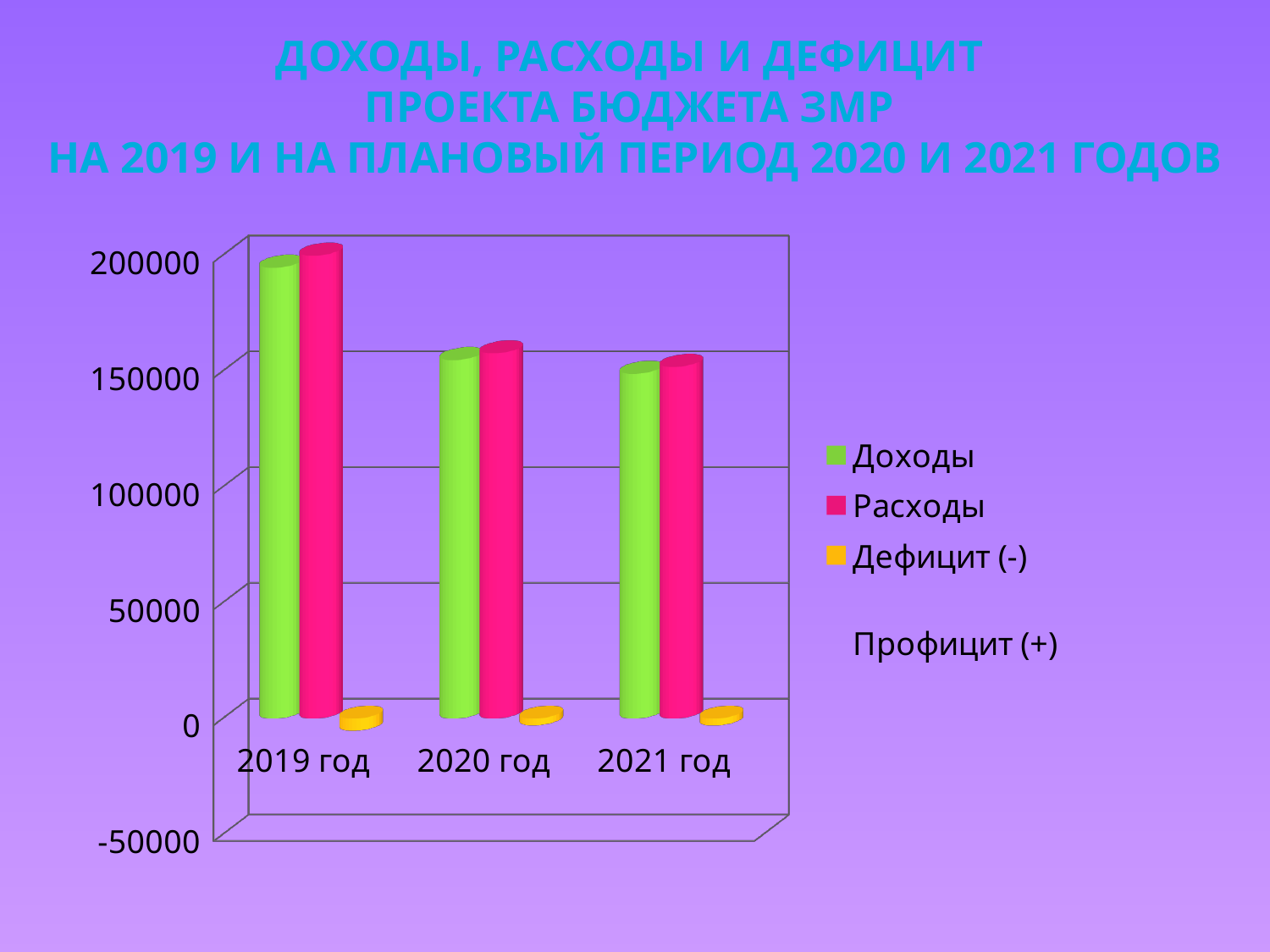
Which year has the highest value for Расходы? 2019 год Do the Доходы values rise or fall from 2019 год to 2021 год? fall Which year has the highest value for Доходы? 2019 год What kind of chart is shown on the slide? bar chart Which is larger: Доходы in 2019 год or Доходы in 2021 год? Доходы in 2019 год How many year categories are shown on the x axis? 3 What colour are the Расходы bars? pink Is the value for Расходы in 2020 год greater or less than 150000? greater Is the value for Доходы in 2019 год greater or less than 150000? greater Is the value for Доходы in 2020 год greater or less than 200000? less How many series does the legend list? 3